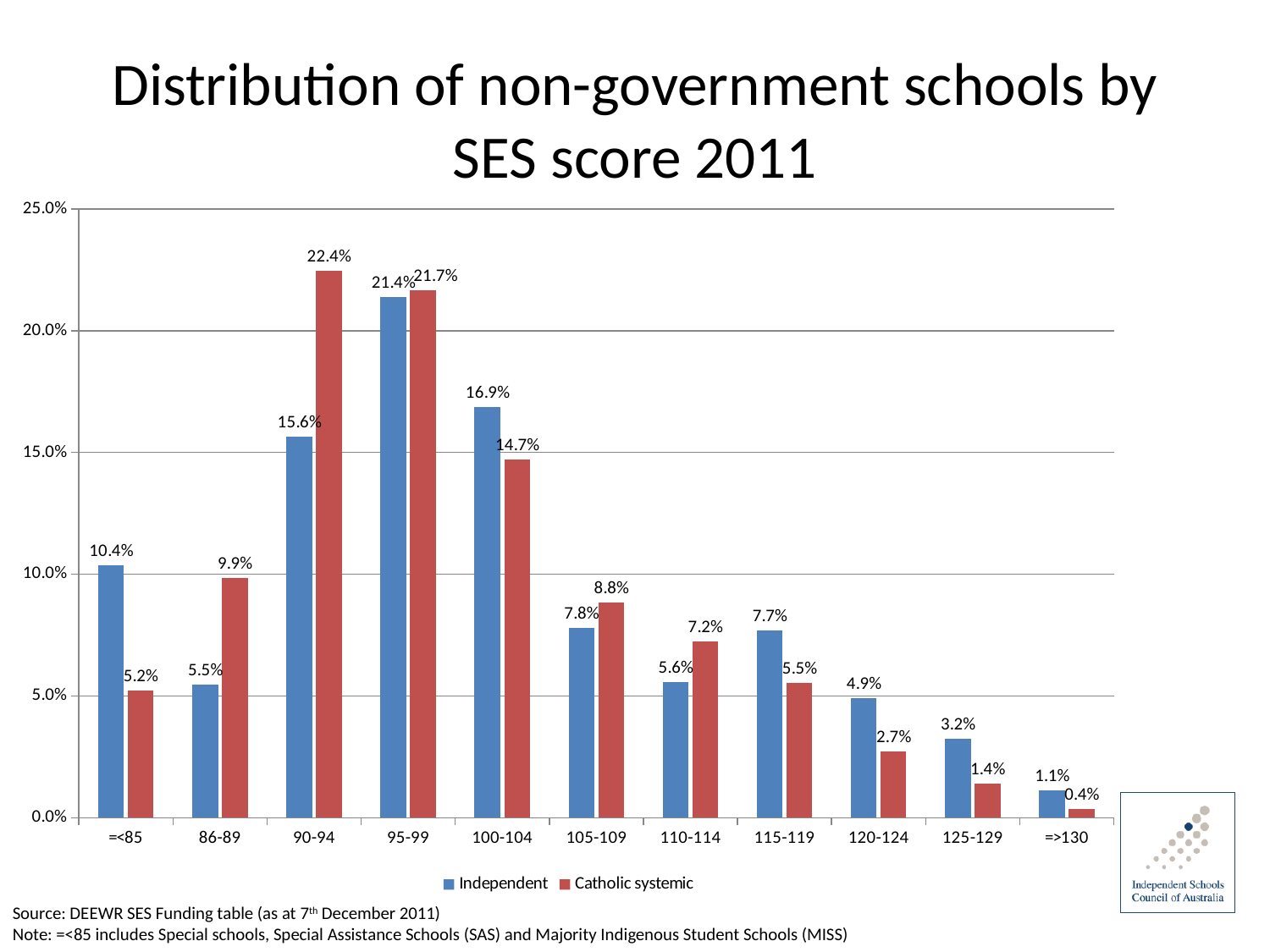
Do the Catholic systemic values rise or fall from the 95-99 band to the =>130 band? Fall How many series does the legend list? 2 What is the Catholic systemic value for the 90-94 SES score band? 22.4% Which SES score band has the highest Catholic systemic value? 90-94 Which SES score band has the lowest Independent value? =>130 What is the difference between the Independent and Catholic systemic values for the 100-104 band? 2.2% Which is larger for the 86-89 band, the Independent value or the Catholic systemic value? Catholic systemic What kind of chart is shown on the slide? Bar chart What is the Independent value for the =<85 SES score band? 10.4% How many SES score bands are shown on the x axis? 11 What is the Catholic systemic value for the =>130 SES score band? 0.4% What is the Independent value for the 95-99 SES score band? 21.4%